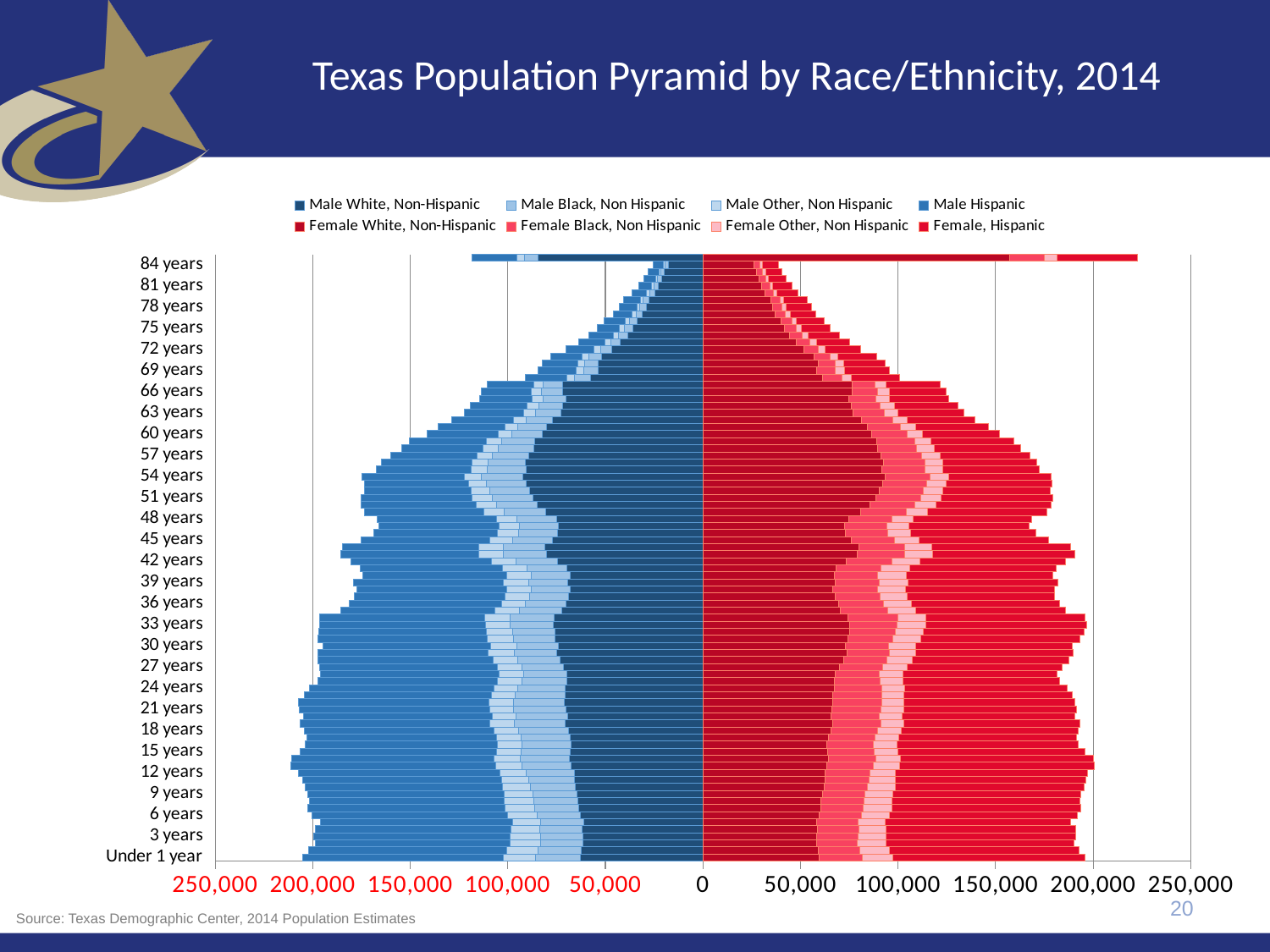
How many series does the legend list? 8 Which is longer, the total female bar for 84 years or the total male bar for 84 years? Female 84 years What is the title of the chart? Texas Population Pyramid by Race/Ethnicity, 2014 Which is larger, the Male Hispanic segment at 12 years or the Male Hispanic segment at 60 years? 12 years Moving down the chart from 81 years to 57 years, do the total male bars generally get longer or shorter? Longer On which side of the chart are the male series plotted, left or right? Left What type of chart is shown on the slide? Bar chart (stacked horizontal population pyramid) Is the total male bar for 81 years greater or less than 50,000? less Is the total female bar for 42 years greater or less than 200,000? less